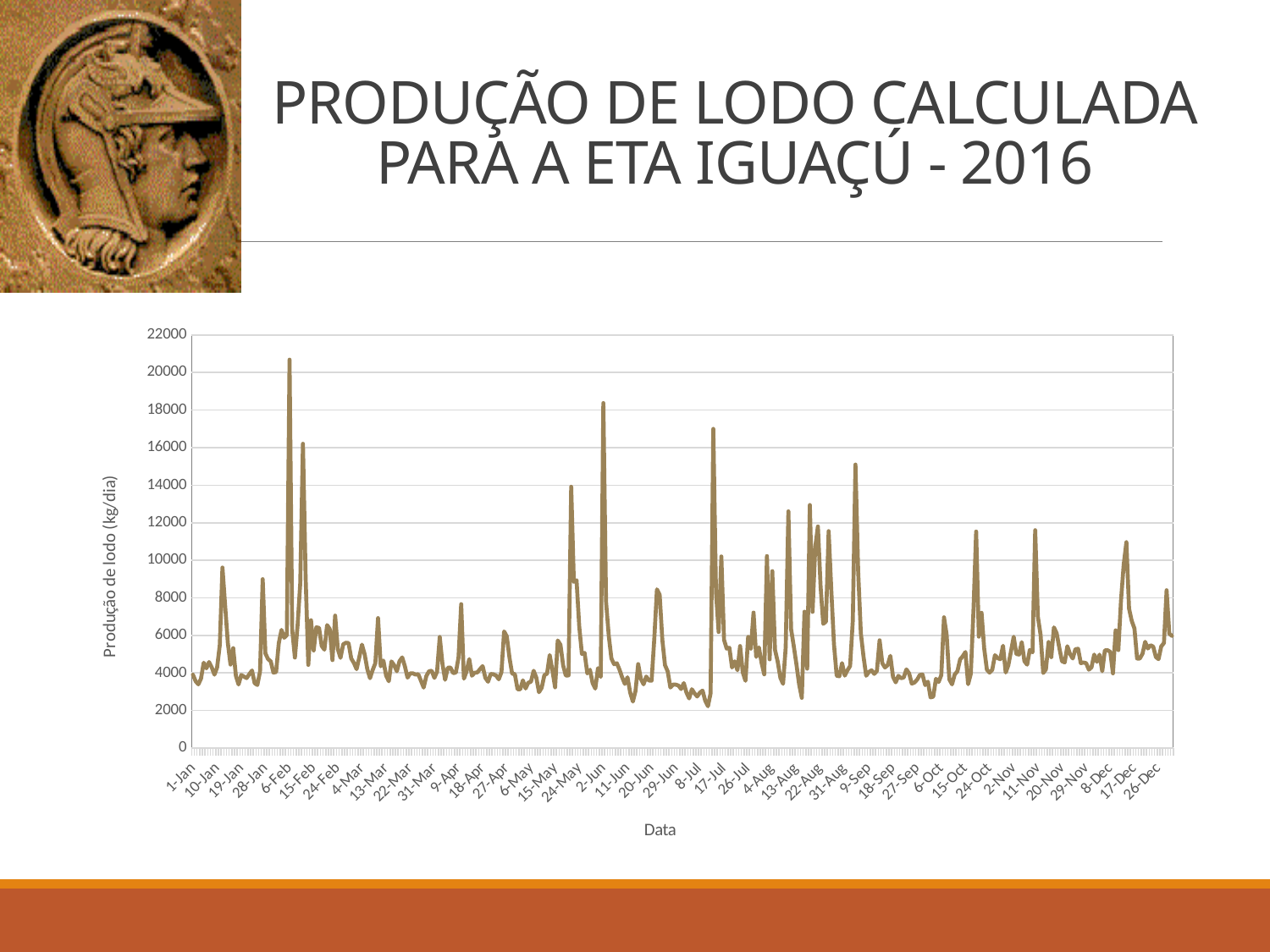
What is the label of the horizontal axis of the chart? Data What is the label of the vertical axis of the chart? Produção de lodo (kg/dia) Is the lowest value of the line, in the dip between 8-Jul and 17-Jul, greater or less than 4000? less Is the peak near 17-Jul greater or less than 16000? greater Is the value at 1-Jan greater or less than 6000? less Which is larger: the peak near 17-Jul or the peak near 9-Sep? the peak near 17-Jul In which month does the highest peak of the line occur? February What kind of chart is shown on the slide? line chart Which is larger: the peak in early February or the peak near 2-Jun? the peak in early February